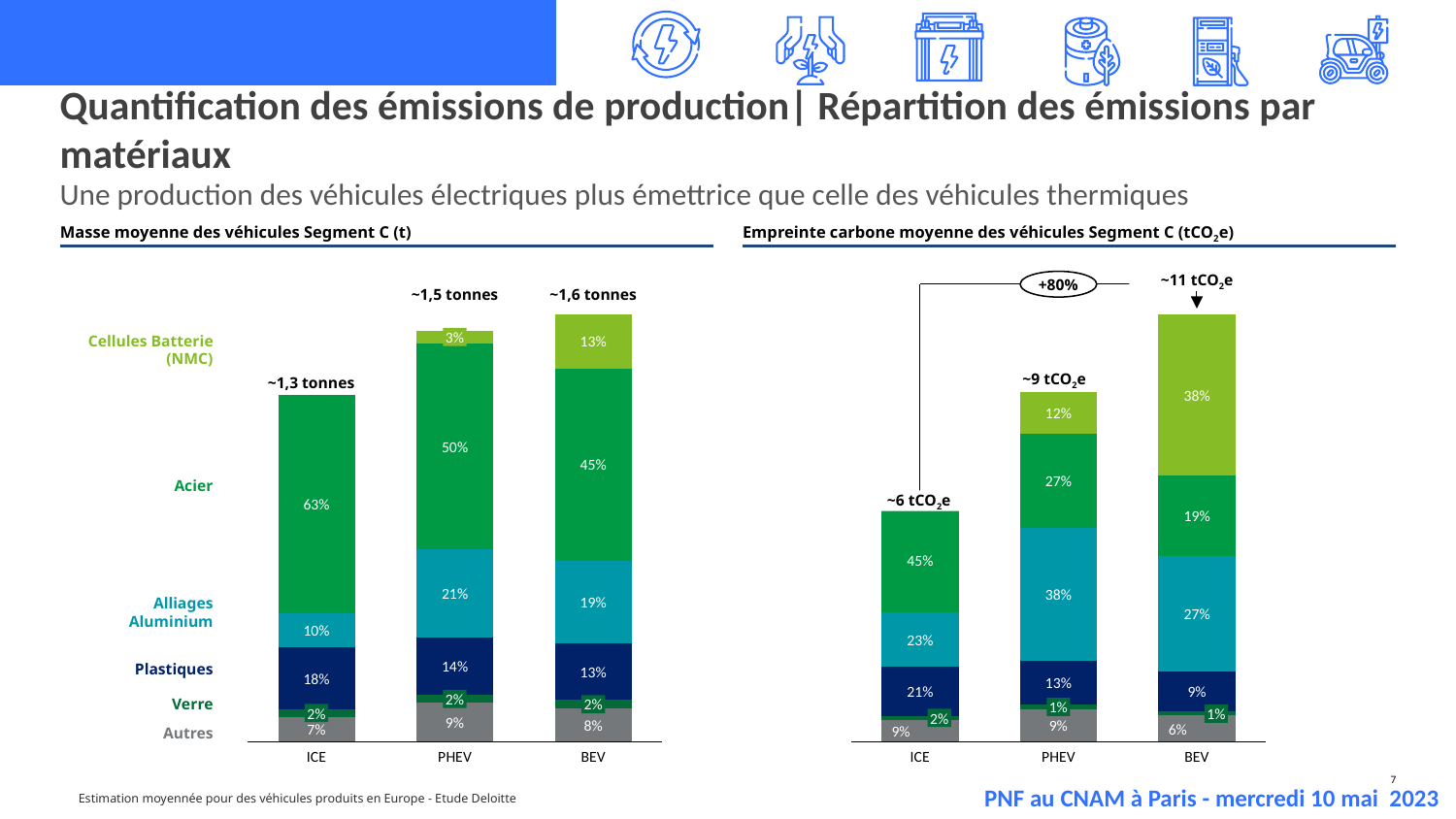
How many material categories are listed in the legend on the left of the slide? 6 How many vehicle types are shown on the x axis of the left chart (Masse moyenne des véhicules Segment C)? 3 In the right chart (Empreinte carbone moyenne des véhicules Segment C), what share of the BEV bar is Cellules Batterie (NMC)? 38% In the left chart (Masse moyenne des véhicules Segment C), what share of the BEV bar is Cellules Batterie (NMC)? 13% In the left chart (Masse moyenne des véhicules Segment C), what share of the ICE bar is Acier? 63% What kind of chart is the right chart (Empreinte carbone moyenne des véhicules Segment C)? Stacked bar chart In the right chart (Empreinte carbone moyenne des véhicules Segment C), what share of the PHEV bar is Alliages Aluminium? 38% In the right chart (Empreinte carbone moyenne des véhicules Segment C), is the Alliages Aluminium share larger for PHEV or for BEV? PHEV In the left chart (Masse moyenne des véhicules Segment C), which vehicle type has the highest Acier share? ICE In the left chart (Masse moyenne des véhicules Segment C), what is the difference between the Acier share of ICE and the Acier share of BEV? 18 percentage points In the right chart (Empreinte carbone moyenne des véhicules Segment C), what percentage increase is annotated between ICE and BEV? +80% In the right chart (Empreinte carbone moyenne des véhicules Segment C), which vehicle type has the lowest Plastiques share? BEV